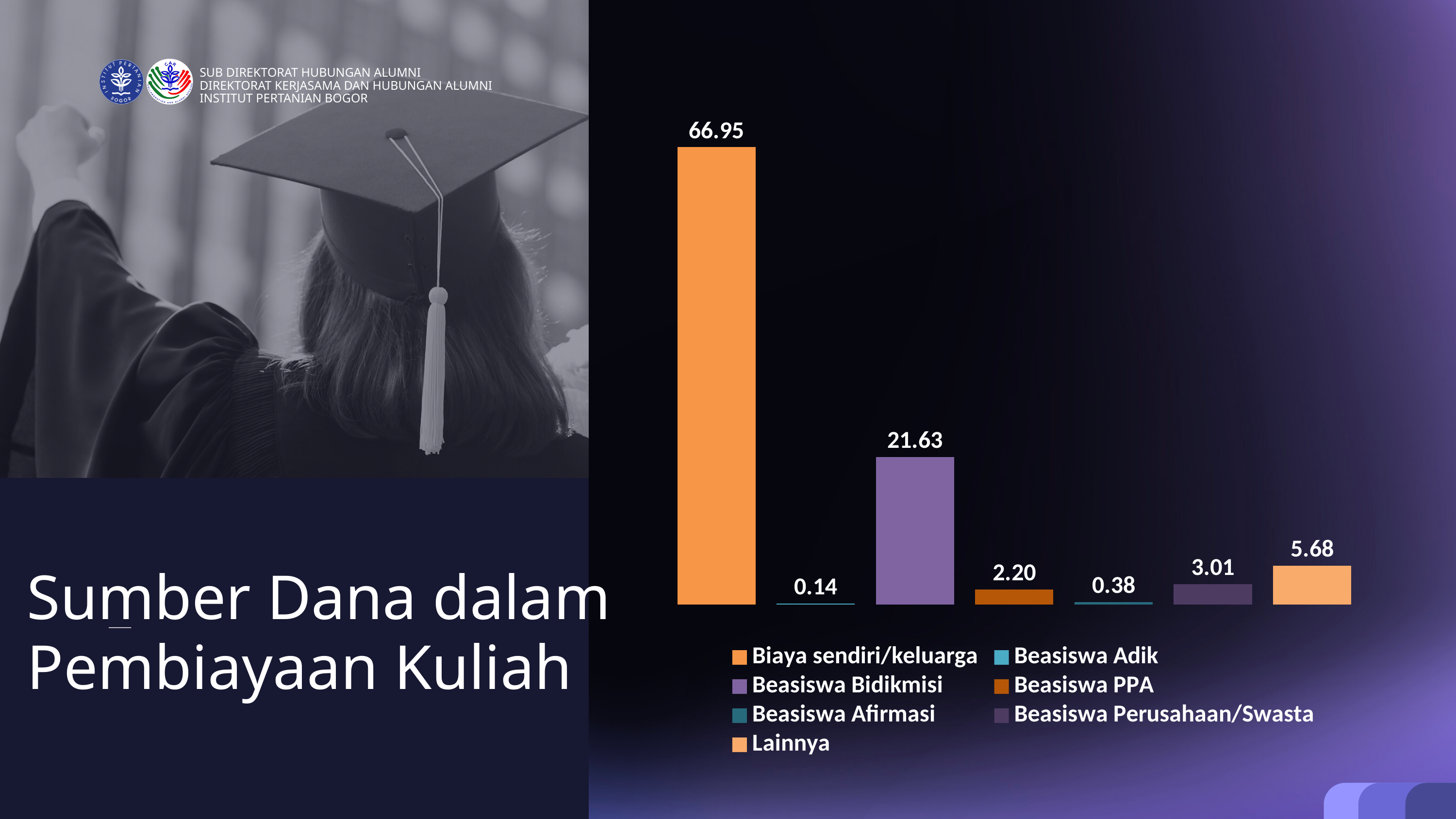
Which category has the highest value? Biaya sendiri/keluarga Which is larger, the value for Beasiswa PPA or the value for Beasiswa Perusahaan/Swasta? Beasiswa Perusahaan/Swasta What is the value for Beasiswa Perusahaan/Swasta? 3.01 What is the value for Biaya sendiri/keluarga? 66.95 How many entries does the legend list? 7 Which category has the lowest value? Beasiswa Adik What is the title of the slide containing the chart? Sumber Dana dalam Pembiayaan Kuliah What is the value for Beasiswa Bidikmisi? 21.63 What kind of chart is shown on the slide? Bar chart How many bars are plotted in the chart? 7 What is the difference between the values for Biaya sendiri/keluarga and Beasiswa Bidikmisi? 45.32 What is the value for Lainnya? 5.68